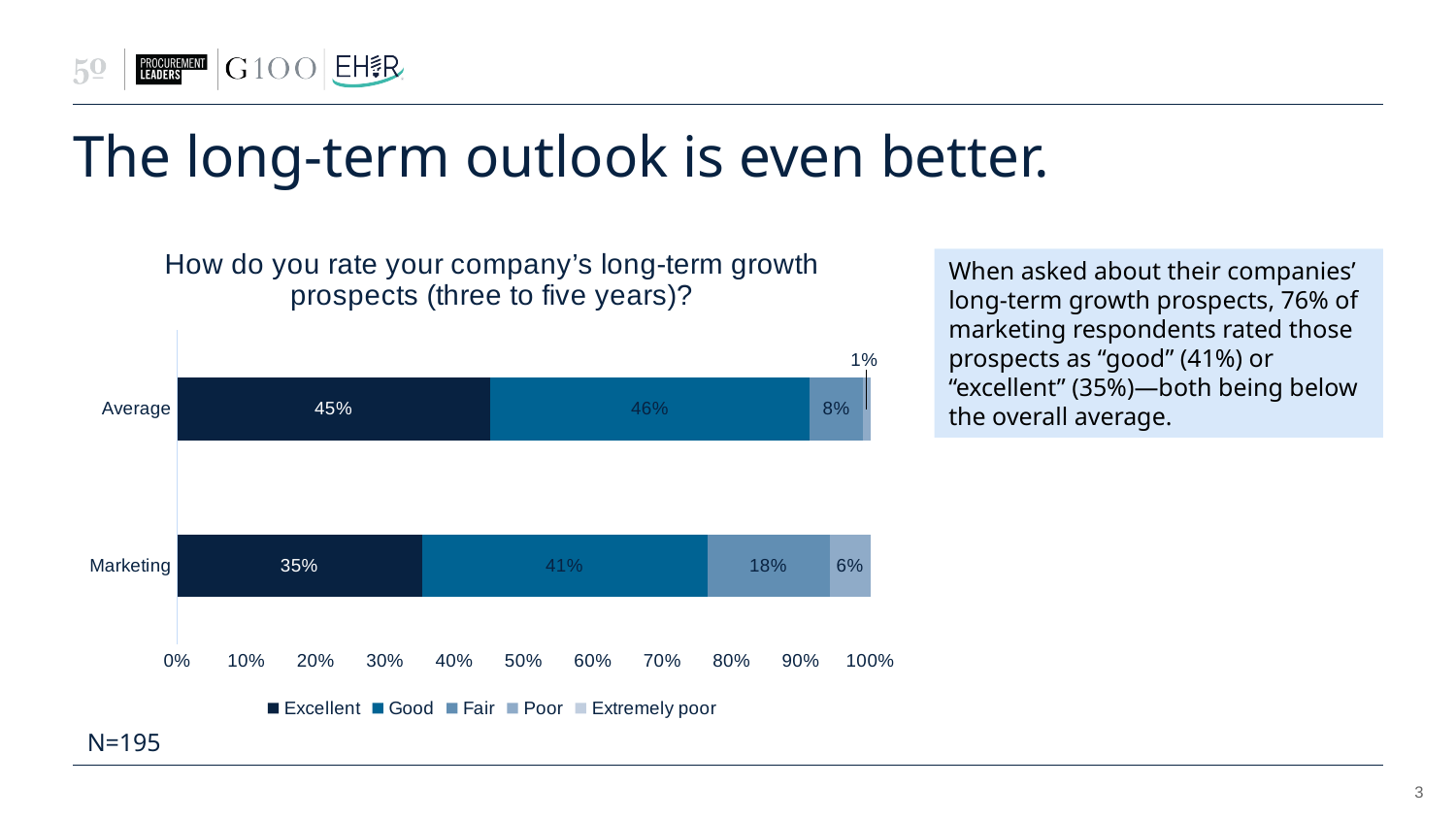
What is the Fair value for Marketing? 18% By how many percentage points does the Fair share for Marketing exceed the Fair share for Average? 10 percentage points How many categories (bars) does the chart show? 2 What is the Poor value for Marketing? 6% What kind of chart is shown on the slide? Stacked bar chart What is the Fair value for the Average bar? 8% How many series does the chart's legend list? 5 What percentage of Marketing respondents rated long-term growth prospects as Excellent? 35% What is the difference between the Excellent share for Average and the Excellent share for Marketing? 10 percentage points What is the title of the chart? How do you rate your company's long-term growth prospects (three to five years)? What is the Good value for the Average bar? 46% Which has the larger Excellent share, Average or Marketing? Average